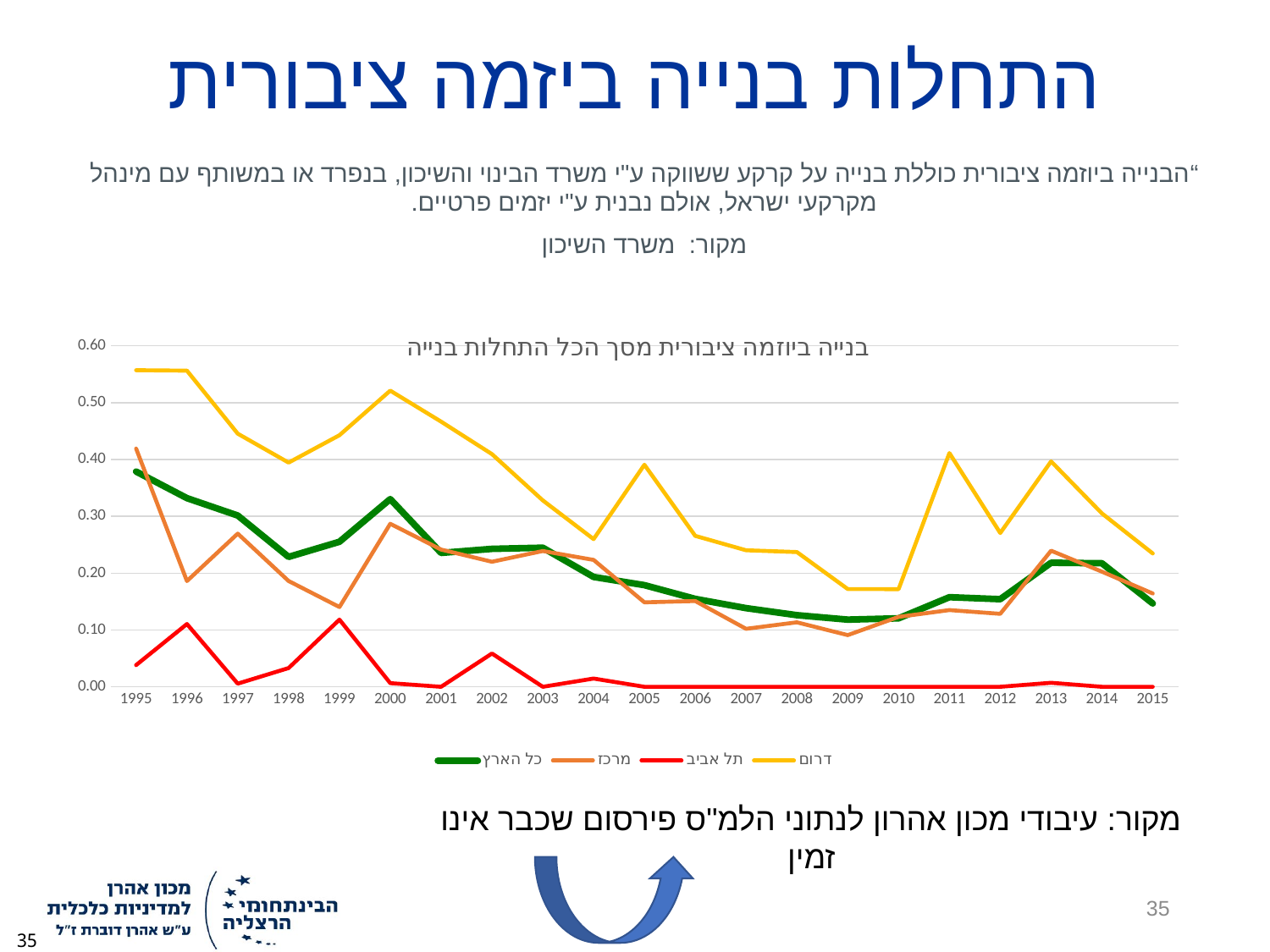
In 1996, which series has the larger value, כל הארץ or מרכז? כל הארץ Is the value for תל אביב in 2000 greater or less than 0.10? less Does the כל הארץ series rise or fall overall from 1995 to 2015? fall What kind of chart is shown on the slide? line chart Is the value for דרום in 1995 greater or less than 0.50? greater Is the value for מרכז in 2007 greater or less than 0.20? less How many series does the chart legend list? 4 How many years are plotted along the x axis of the chart? 21 What colour is the line for כל הארץ? green Which series has the lowest value in 2010? תל אביב In 2005, which series has the larger value, דרום or מרכז? דרום Which series has the highest value in 2011? דרום